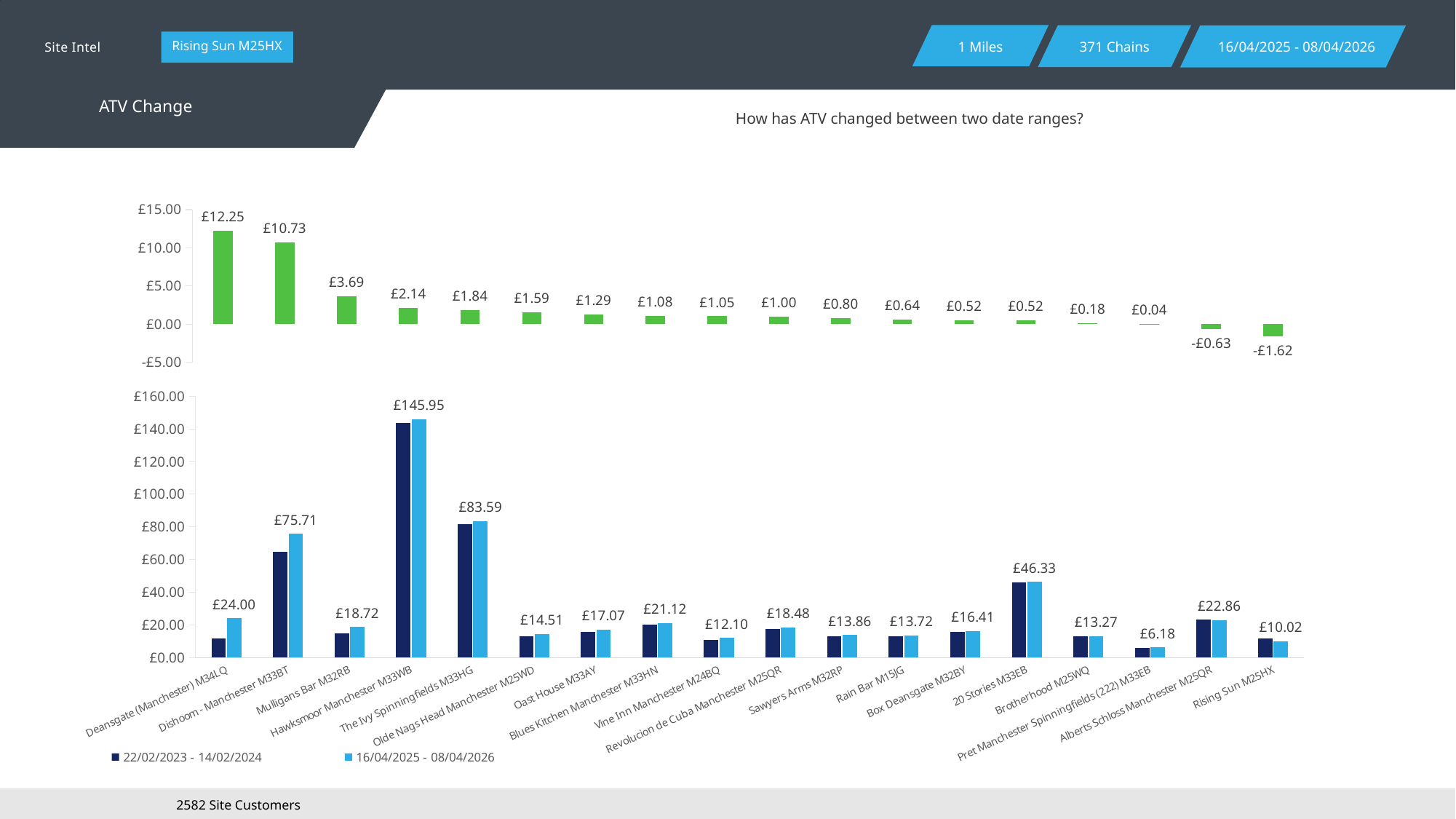
How many categories are shown on the x axis of the bottom chart? 18 In the bottom chart, which has the larger 16/04/2025 - 08/04/2026 value: Oast House M33AY or Blues Kitchen Manchester M33HN? Blues Kitchen Manchester M33HN In the bottom chart, what is the value for Rising Sun M25HX in the 16/04/2025 - 08/04/2026 series? £10.02 In the bottom chart, is the 22/02/2023 - 14/02/2024 value for The Ivy Spinningfields M33HG greater or less than £100.00? less How many series does the legend of the bottom chart list? 2 In the top chart, what is the highest value shown? £12.25 In the bottom chart, which category has the highest value in the 16/04/2025 - 08/04/2026 series? Hawksmoor Manchester M33WB What kind of chart is the top chart? bar chart In the top chart, what is the lowest value shown? -£1.62 In the bottom chart, which category has the lowest value in the 16/04/2025 - 08/04/2026 series? Pret Manchester Spinningfields (222) M33EB In the bottom chart, what is the value for Dishoom - Manchester M33BT in the 16/04/2025 - 08/04/2026 series? £75.71 In the bottom chart, what is the difference between the 16/04/2025 - 08/04/2026 values for Hawksmoor Manchester M33WB and The Ivy Spinningfields M33HG? £62.36